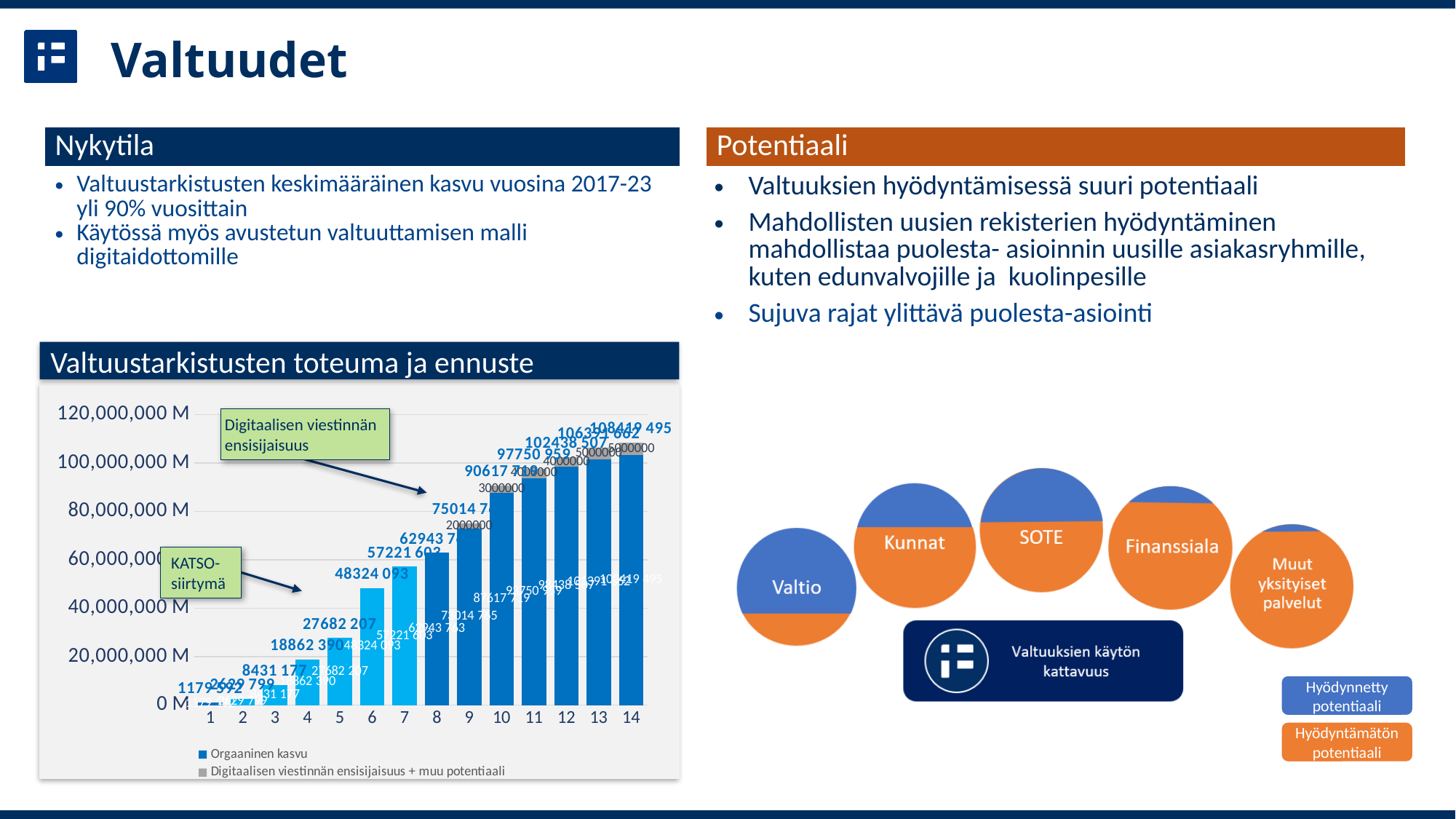
In the chart 'Valtuustarkistusten toteuma ja ennuste', which is larger: the 'Orgaaninen kasvu' value for category 5 or for category 4? category 5 In the chart 'Valtuustarkistusten toteuma ja ennuste', do the 'Orgaaninen kasvu' values rise or fall from category 1 to category 14? rise In the chart 'Valtuustarkistusten toteuma ja ennuste', is the 'Orgaaninen kasvu' value for category 9 greater or less than 60,000,000 M? greater In the chart 'Valtuustarkistusten toteuma ja ennuste', how many categories are shown on the x axis? 14 In the chart 'Valtuustarkistusten toteuma ja ennuste', what is the name of the second series in the legend? Digitaalisen viestinnän ensisijaisuus + muu potentiaali In the chart 'Valtuustarkistusten toteuma ja ennuste', what is the 'Orgaaninen kasvu' value labelled for category 14? 103419 495 In the chart 'Valtuustarkistusten toteuma ja ennuste', what is the 'Orgaaninen kasvu' value labelled for category 6? 48324 093 In the chart 'Valtuustarkistusten toteuma ja ennuste', which category has the lowest 'Orgaaninen kasvu' value? 1 In the chart 'Valtuustarkistusten toteuma ja ennuste', how many series does the legend list? 2 In the chart 'Valtuustarkistusten toteuma ja ennuste', what is the 'Orgaaninen kasvu' value labelled for category 4? 18862 390 What kind of chart is 'Valtuustarkistusten toteuma ja ennuste'? bar chart In the chart 'Valtuustarkistusten toteuma ja ennuste', which category has the highest 'Orgaaninen kasvu' value? 14